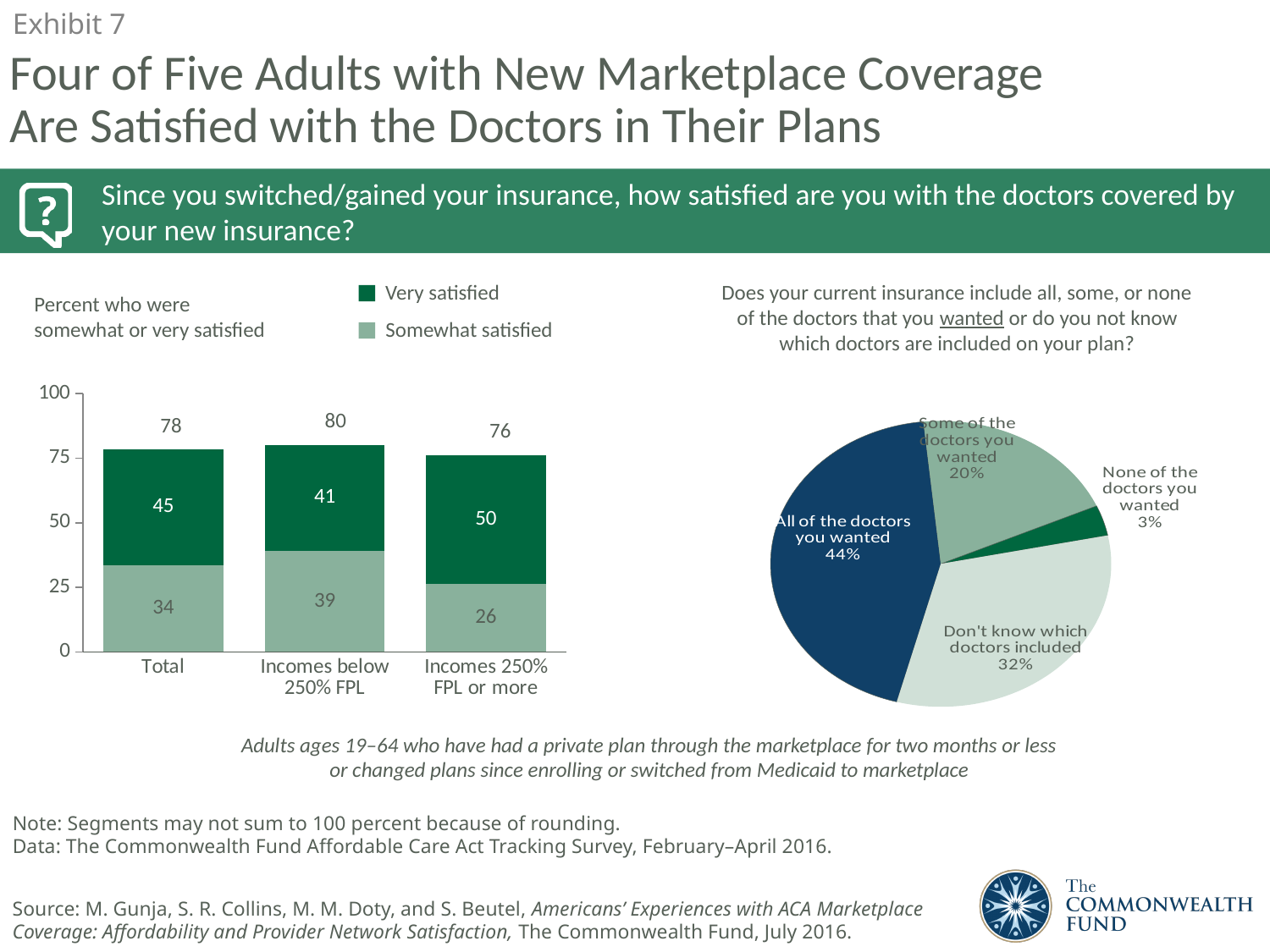
In the bar chart on the left, what is the total of the stacked bar for Incomes below 250% FPL? 80 In the pie chart on the right, which slice is the largest? All of the doctors you wanted In the pie chart on the right, which is larger: Some of the doctors you wanted or Don't know which doctors included? Don't know which doctors included In the pie chart on the right, what share of respondents said they don't know which doctors are included? 32% In the bar chart on the left, which category has the highest total percent somewhat or very satisfied? Incomes below 250% FPL In the bar chart on the left, how many categories are shown on the x axis? 3 In the bar chart on the left, which category has the lowest Somewhat satisfied value? Incomes 250% FPL or more What kind of chart is the chart on the left of the slide? Stacked bar chart In the bar chart on the left, what is the value for Very satisfied in the Incomes 250% FPL or more category? 50 In the bar chart on the left, what is the difference between the Very satisfied values for Incomes 250% FPL or more and Incomes below 250% FPL? 9 In the bar chart on the left, how many series does the legend list? 2 In the bar chart on the left, what is the value for Somewhat satisfied in the Total category? 34